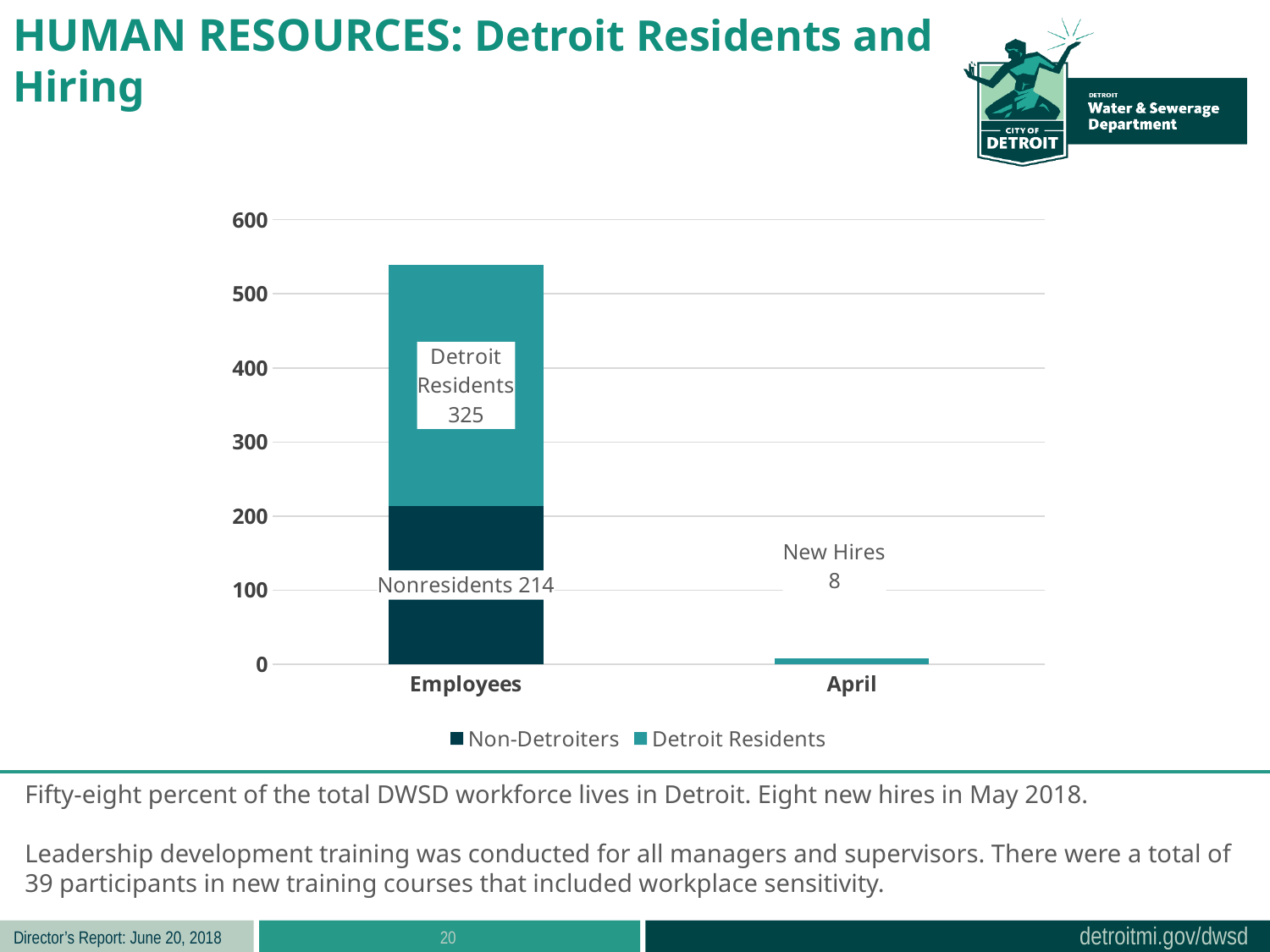
What kind of chart is shown on the slide? stacked bar chart Which is larger in the Employees bar, Detroit Residents or Nonresidents? Detroit Residents What is the value labelled New Hires for April? 8 What are the two series named in the legend? Non-Detroiters and Detroit Residents What is the value for Nonresidents in the Employees bar? 214 What is the total of the stacked Employees bar? 539 Is the total of the Employees bar greater or less than 500? greater How many series does the legend list? 2 How many categories are shown on the x axis? 2 Which category has the lower total, Employees or April? April What is the value for Detroit Residents in the Employees bar? 325 What is the difference between Detroit Residents (325) and Nonresidents (214) in the Employees bar? 111